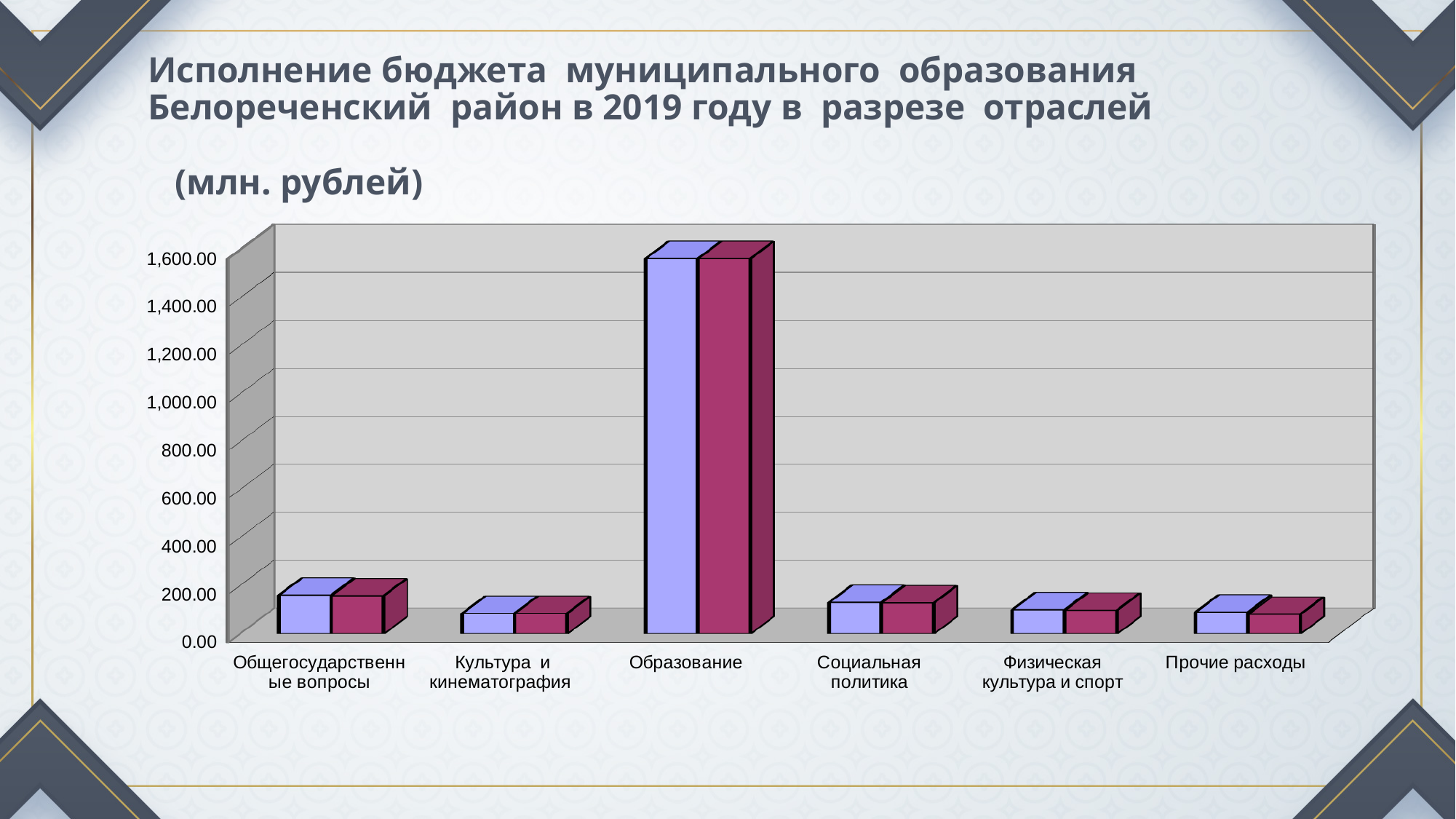
What is the highest value shown on the chart's vertical axis? 1,600.00 Is the value for Физическая культура и спорт greater or less than 200.00? less Which category has the highest bars in the chart? Образование In what units are the values on the chart expressed, according to the slide? млн. рублей Which is larger, the value for Общегосударственные вопросы or the value for Культура и кинематография? Общегосударственные вопросы Is the value for Общегосударственные вопросы greater or less than 400.00? less How many categories are shown on the x axis of the chart? 6 Is the value for Образование greater or less than 1,400.00? greater Which is larger, the value for Образование or the value for Социальная политика? Образование What kind of chart is shown on the slide? bar chart